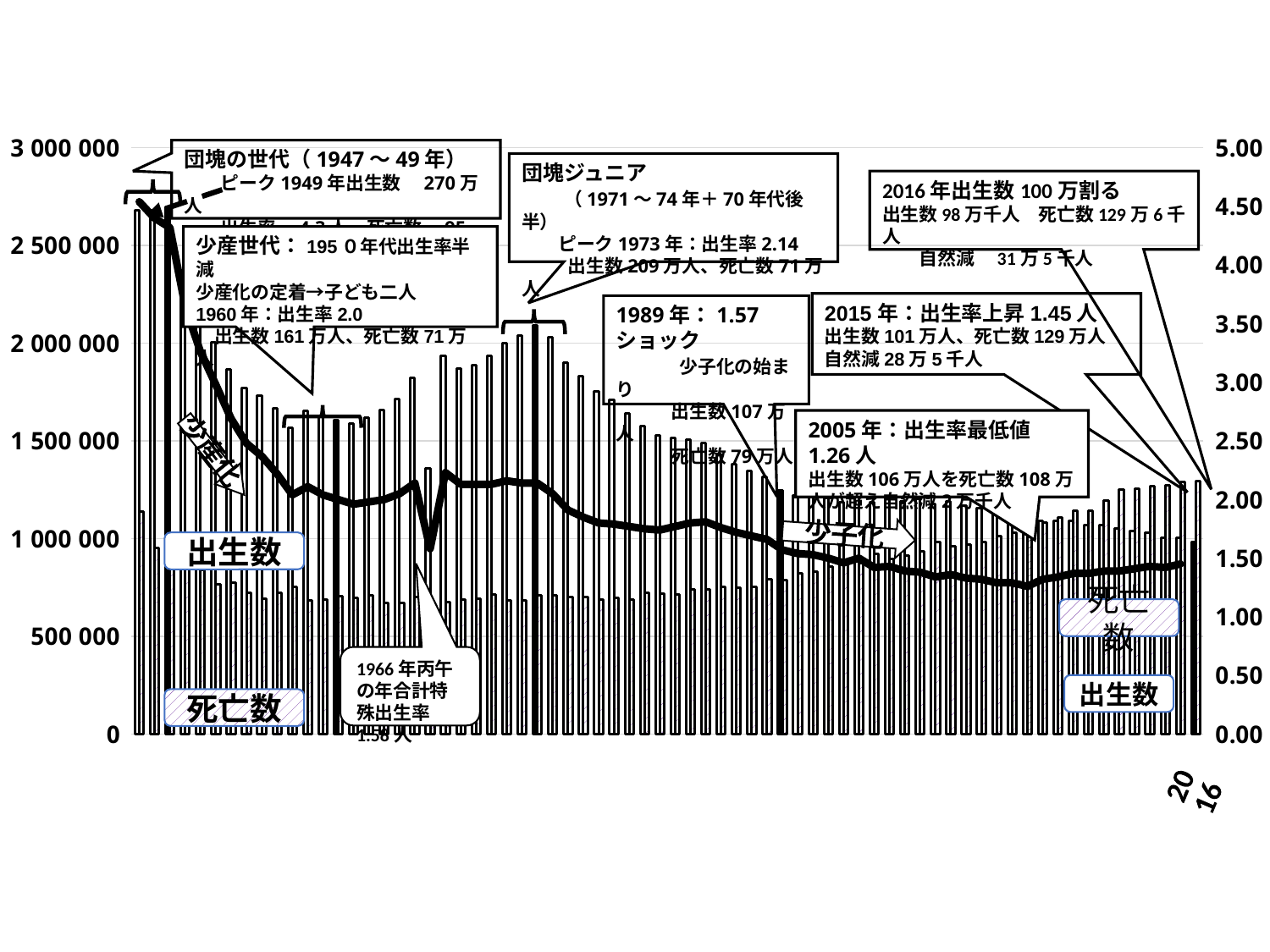
What kind of chart is shown on the slide? bar chart with a line Is the value of the thick line at the far right of the chart (2016) greater or less than 2.00 on the right axis? less Is the value of the thick line at the far left of the chart greater or less than 4.00 on the right axis? greater According to the annotation, in which year did the fertility rate reach its lowest value? 2005年 According to the annotation, what was the lowest fertility rate value reached in 2005? 1.26人 Is the leftmost birth (出生数) bar greater or less than 2 500 000? greater What is the highest value shown on the right vertical axis? 5.00 According to the annotation, what was the peak fertility rate in 1973? 2.14 Which is taller, the leftmost birth (出生数) bar or the rightmost birth bar for 2016? the leftmost bar Does the thick line (fertility rate) generally rise or fall from left to right across the chart? fall What is the highest value shown on the left vertical axis? 3 000 000 According to the annotation, what was the number of births in 2016? 98万千人